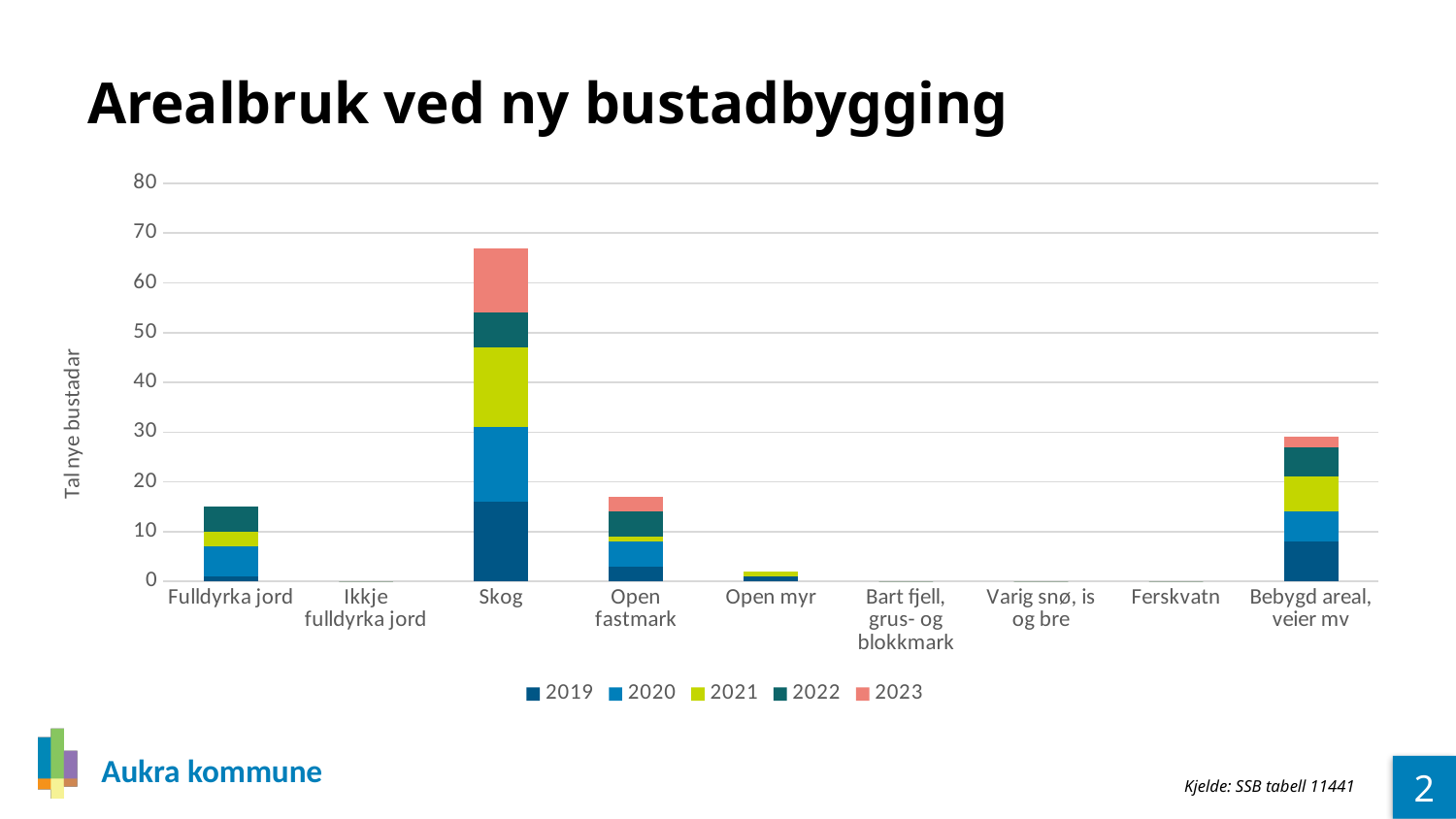
Is the total stacked value for Bebygd areal, veier mv greater or less than 20? greater Is the total stacked value for Skog greater or less than 60? greater Is the total stacked value for Open myr greater or less than 10? less Which has the larger total stacked bar, Skog or Bebygd areal, veier mv? Skog How many series does the legend list? 5 How many categories are shown on the x axis of the chart? 9 What is the title of the chart? Arealbruk ved ny bustadbygging Which category has the highest total stacked bar? Skog What is the label on the y axis of the chart? Tal nye bustadar What kind of chart is shown on the slide? stacked bar chart